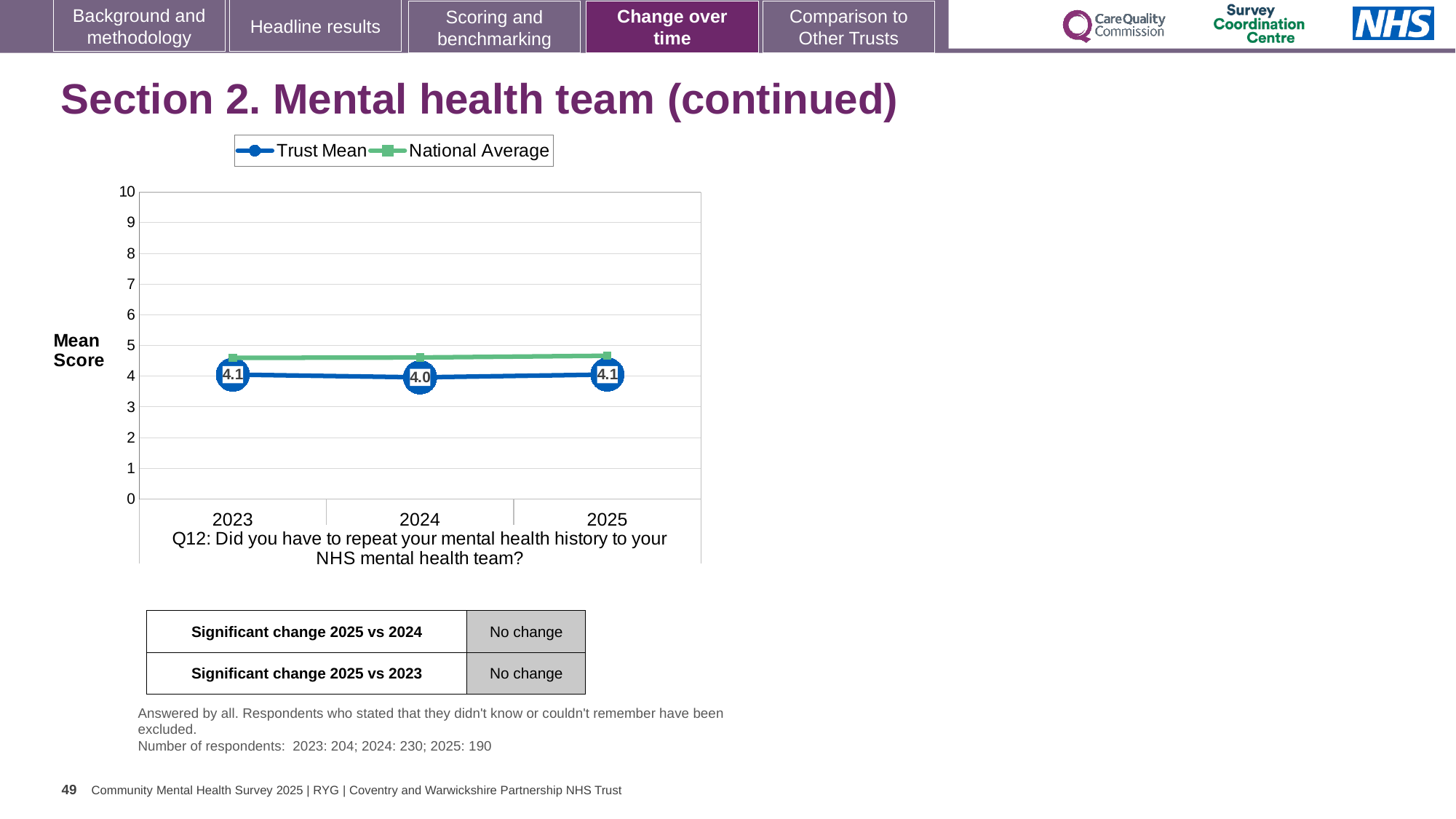
What is the Trust Mean value for 2024? 4.0 In which year is the Trust Mean lowest? 2024 How many years are shown on the x axis of the chart? 3 How many series does the chart legend list? 2 Is the National Average value for 2023 greater or less than 5? less What is the label on the y axis of the chart? Mean Score What kind of chart is shown on the slide? Line chart What is the difference between the Trust Mean in 2023 and in 2024? 0.1 What is the Trust Mean value for 2023? 4.1 What is the Trust Mean value for 2025? 4.1 In 2025, which series has the higher value, Trust Mean or National Average? National Average Is the National Average value for 2025 greater or less than 4? greater